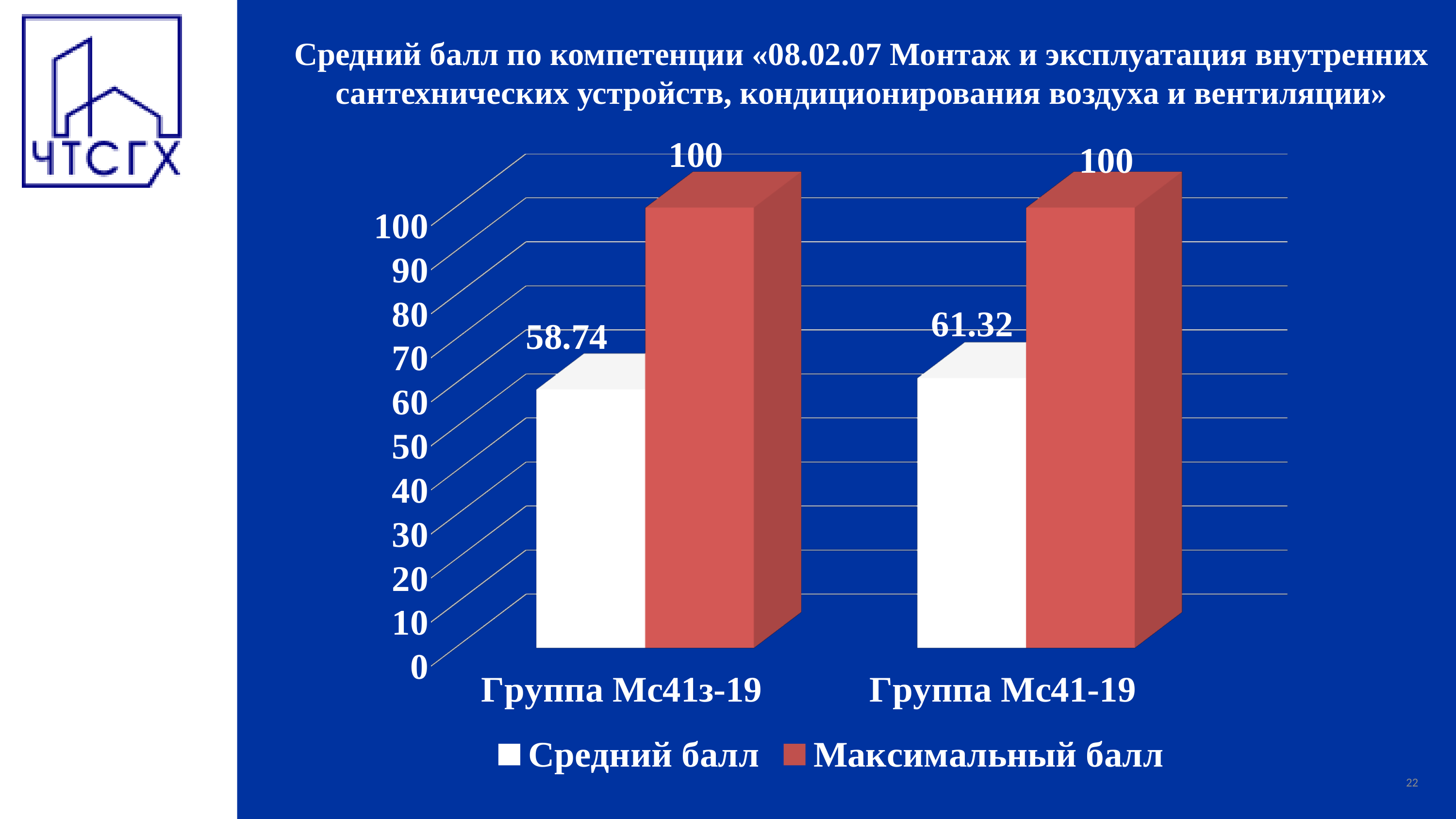
What is the Максимальный балл for Группа Мс41з-19? 100 What kind of chart is shown on the slide? Bar chart What is the difference between the Максимальный балл and the Средний балл for Группа Мс41з-19? 41.26 Which group has the lower Средний балл? Группа Мс41з-19 How many series does the legend list? 2 Is the Средний балл for Группа Мс41-19 greater or less than 60? greater Which group has the higher Средний балл? Группа Мс41-19 What is the difference between the Средний балл of Группа Мс41-19 and Группа Мс41з-19? 2.58 Is the Средний балл for Группа Мс41з-19 greater or less than 60? less What is the Средний балл for Группа Мс41-19? 61.32 What is the Средний балл for Группа Мс41з-19? 58.74 How many groups are shown on the x axis? 2